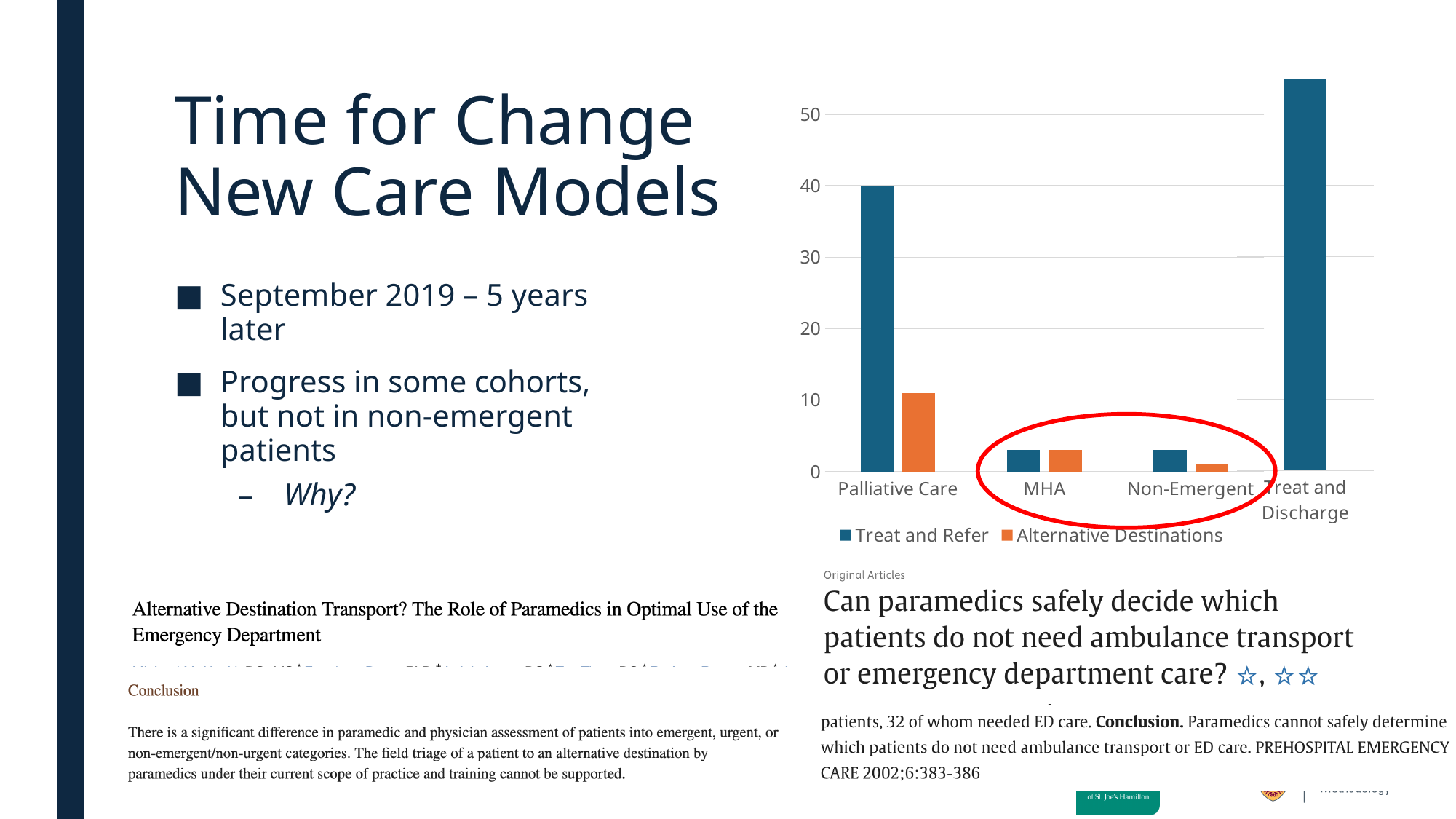
Which category has the highest Treat and Refer value? Treat and Discharge Is the Alternative Destinations value for Non-Emergent greater or less than 10? less For Palliative Care, which series has the larger value: Treat and Refer or Alternative Destinations? Treat and Refer How many categories are shown on the x axis of the chart? 4 Which category on the chart is circled in red? MHA and Non-Emergent What is the Treat and Refer value for Palliative Care? 40 Which series is shown in orange in the chart's legend? Alternative Destinations What kind of chart is shown on the slide? bar chart Is the Alternative Destinations value for Palliative Care greater or less than 10? greater Is the Treat and Refer value for Treat and Discharge greater or less than 50? greater How many series does the chart's legend list? 2